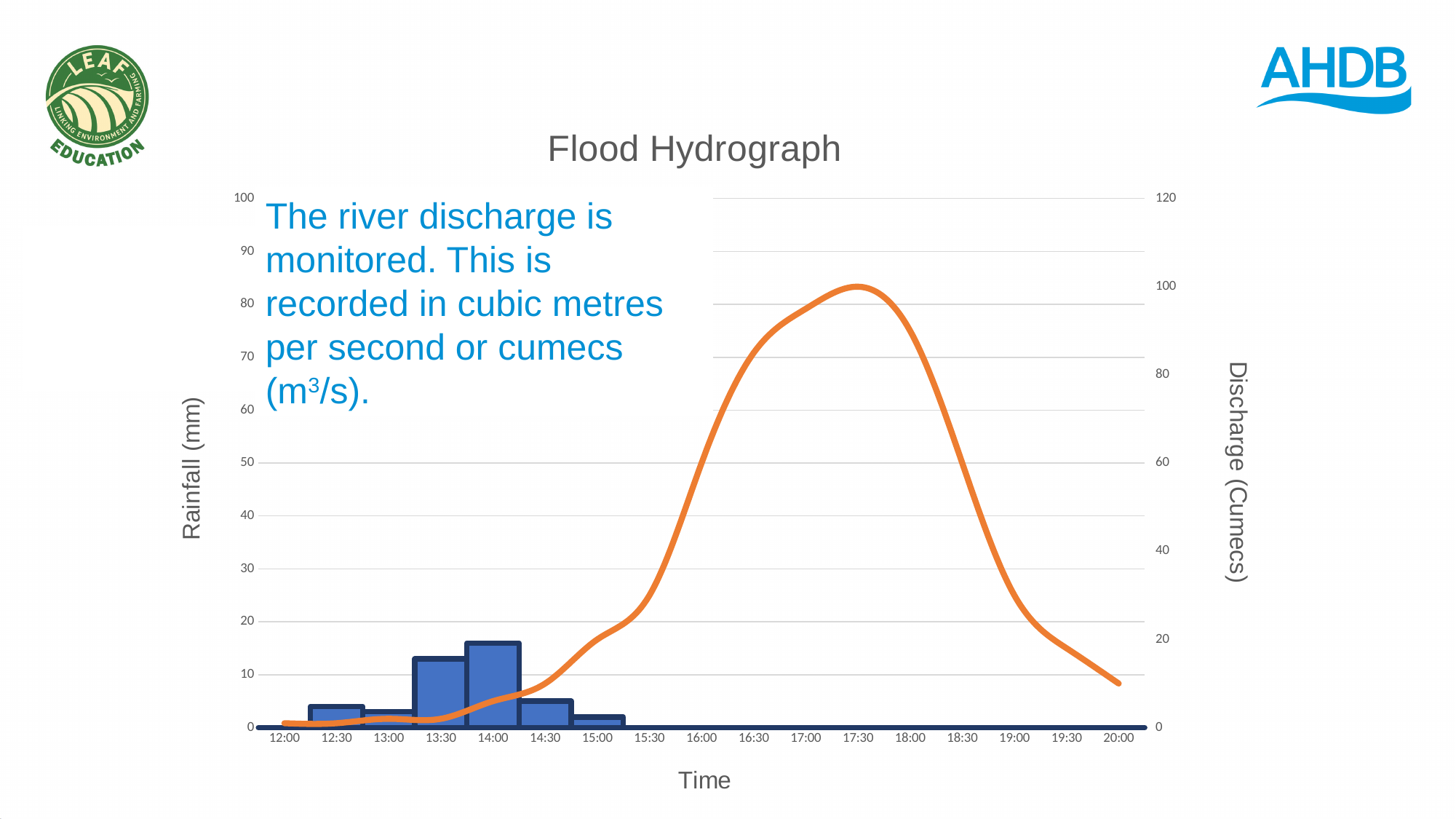
At which time does the discharge line reach its peak? 17:30 Is the discharge value at 20:00 greater or less than 20? less Is the discharge value at 17:30 greater or less than 80? greater What is the title of the chart? Flood Hydrograph Does the discharge line rise or fall between 17:30 and 20:00? falls At which time is the rainfall bar the tallest? 14:00 Does the discharge line rise or fall between 15:00 and 17:30? rises What kind of chart is shown on the slide? Combined bar and line chart What is the label on the left vertical axis? Rainfall (mm) Is the rainfall value at 14:00 greater or less than 10? greater Which has the higher rainfall bar, 13:30 or 14:30? 13:30